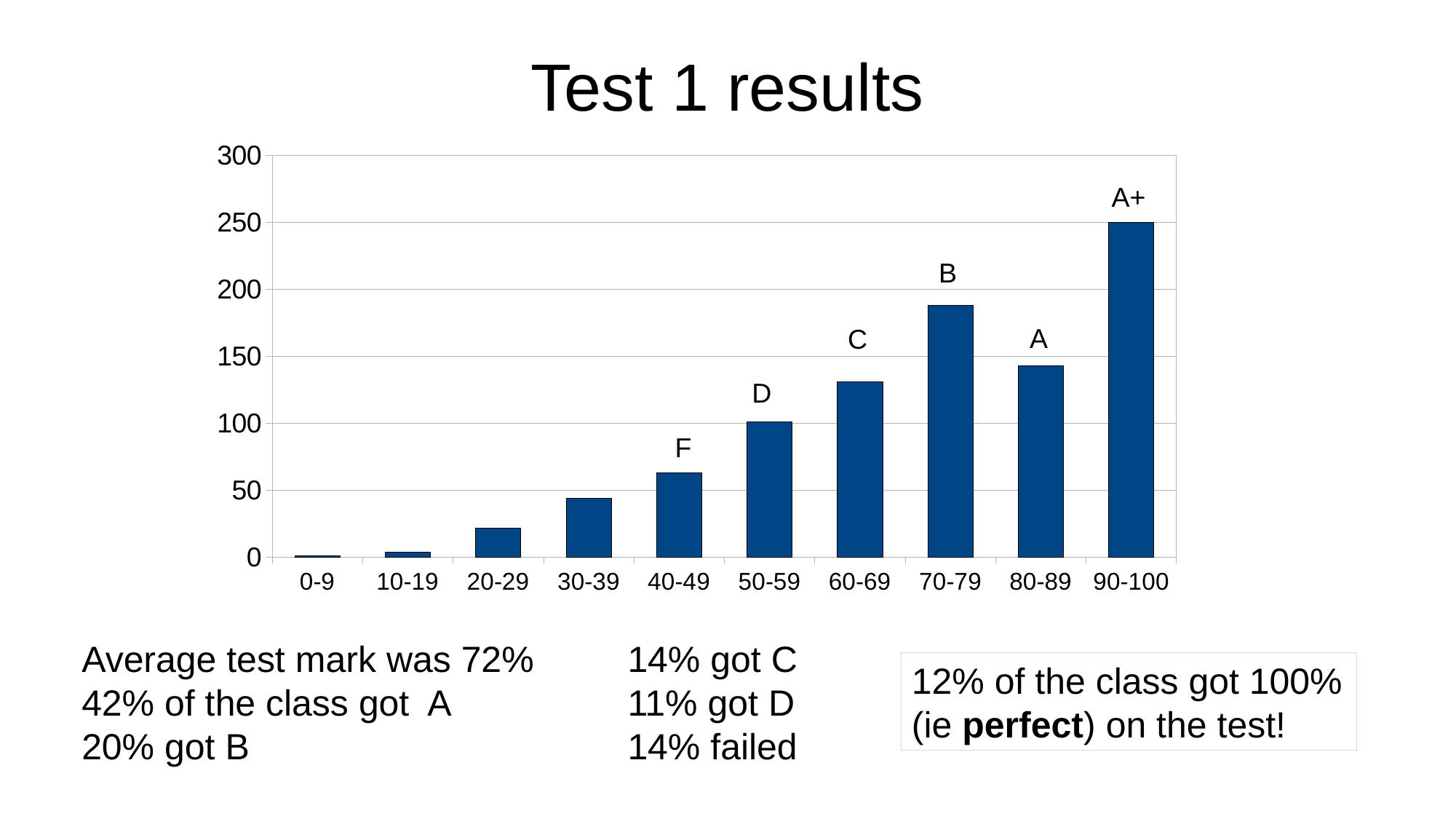
What grade label is printed above the 40-49 bar? F Is the value for 30-39 greater or less than 50? less Is the value for 40-49 greater or less than 50? greater What grade label is printed above the 90-100 bar? A+ Which score range has the highest bar? 90-100 How many score ranges are shown on the x axis? 10 Which score range has the lowest bar? 0-9 Is the value for 70-79 greater or less than 150? greater What kind of chart is shown on the slide? bar chart Which is larger, the value for 70-79 or the value for 80-89? 70-79